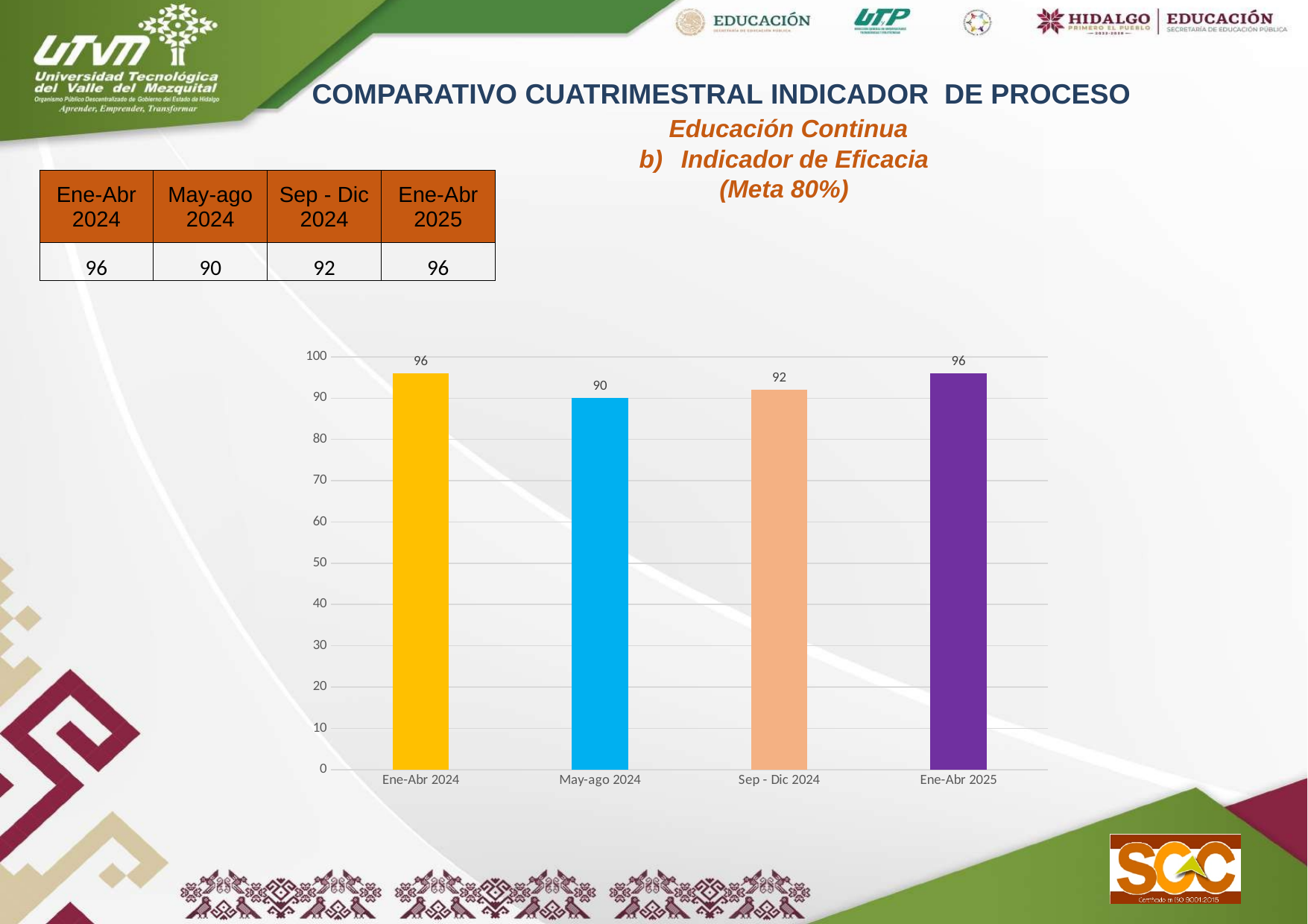
What is the value for May-ago 2024? 90 What kind of chart is shown on the slide? bar chart Which is larger, the value for Sep - Dic 2024 or the value for May-ago 2024? Sep - Dic 2024 Which period has the lowest value? May-ago 2024 Is the value for May-ago 2024 greater or less than 80? greater Do the values rise or fall from May-ago 2024 to Ene-Abr 2025? rise How many periods are shown on the x axis of the chart? 4 What is the value for Sep - Dic 2024? 92 What is the difference between the values for Ene-Abr 2024 and May-ago 2024? 6 What is the difference between the values for Ene-Abr 2025 and Sep - Dic 2024? 4 What colour is the bar for Ene-Abr 2025? purple What is the value for Ene-Abr 2025? 96